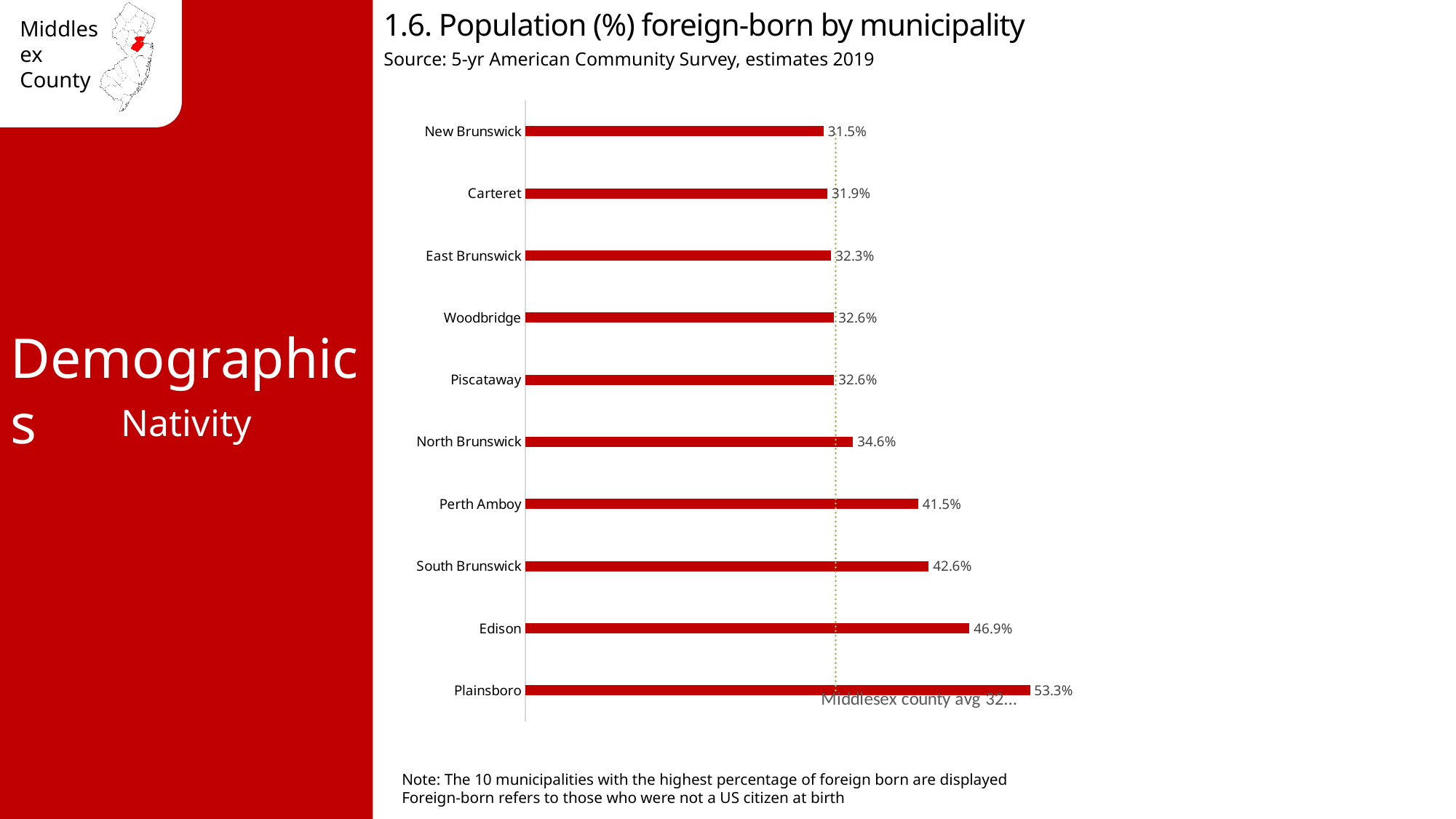
What is the percentage of foreign-born population in Plainsboro? 53.3% What is the difference in percentage points between Edison and South Brunswick? 4.3 What is the source of the data shown in the chart? 5-yr American Community Survey, estimates 2019 What is the difference in percentage points between Plainsboro and New Brunswick? 21.8 How many municipalities are shown on the chart? 10 Which municipality has the lowest percentage of foreign-born population shown on the chart? New Brunswick What kind of chart is shown on the slide? Bar chart Which has a higher foreign-born percentage, North Brunswick or Carteret? North Brunswick What is the percentage of foreign-born population in Perth Amboy? 41.5% What is the percentage of foreign-born population in New Brunswick? 31.5% Which municipality has the highest percentage of foreign-born population? Plainsboro Which two municipalities share the same foreign-born percentage of 32.6%? Woodbridge and Piscataway